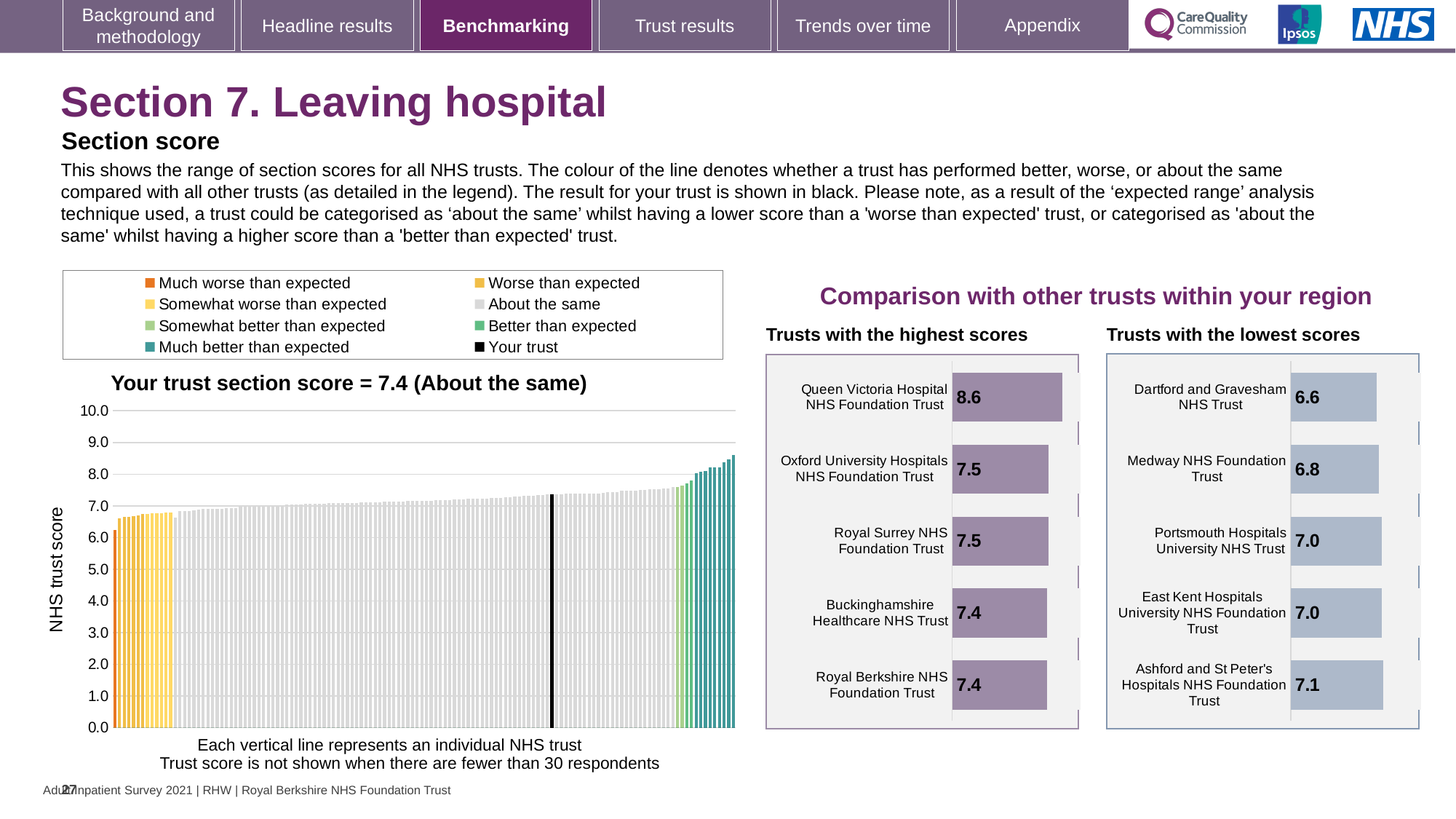
In the 'Trusts with the lowest scores' chart, how many trusts are shown? 5 In the 'Your trust section score' chart, do the bars rise or fall from left to right? Rise In the 'Trusts with the highest scores' chart, what is the difference between the scores of Queen Victoria Hospital NHS Foundation Trust and Royal Berkshire NHS Foundation Trust? 1.2 In the 'Your trust section score' chart, how many entries does the legend list? 8 In the 'Your trust section score' chart, what is the label of the vertical axis? NHS trust score In the 'Trusts with the highest scores' chart, what is the score for Queen Victoria Hospital NHS Foundation Trust? 8.6 In the 'Your trust section score' chart, what is the section score for your trust? 7.4 In the 'Trusts with the lowest scores' chart, which has the larger score: Medway NHS Foundation Trust or Ashford and St Peter's Hospitals NHS Foundation Trust? Ashford and St Peter's Hospitals NHS Foundation Trust What kind of chart is the 'Your trust section score' chart? Bar chart In the 'Trusts with the highest scores' chart, which trust has the highest score? Queen Victoria Hospital NHS Foundation Trust In the 'Your trust section score' chart, is the value of the tallest bar greater or less than 8.0? greater In the 'Trusts with the lowest scores' chart, which trust has the lowest score? Dartford and Gravesham NHS Trust